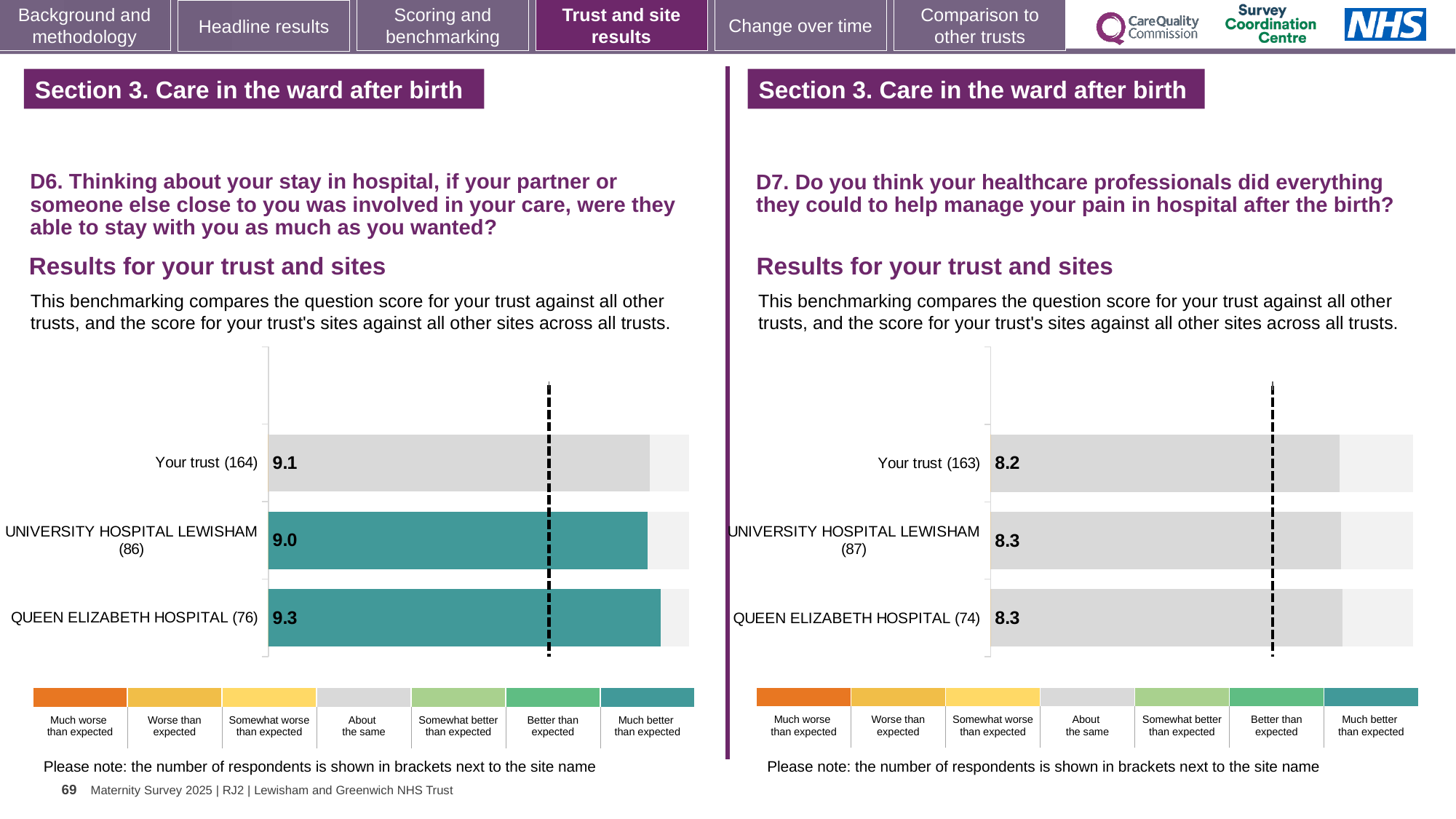
In the D6 chart on the left, which bar has the highest score? QUEEN ELIZABETH HOSPITAL (76) In the D7 chart on the right, how many bars are plotted? 3 In the D6 chart on the left, what is the score for Your trust (164)? 9.1 In the D6 chart on the left, what is the score for QUEEN ELIZABETH HOSPITAL (76)? 9.3 In the D6 chart on the left, what is the score for UNIVERSITY HOSPITAL LEWISHAM (86)? 9.0 In the D6 chart on the left, what colour are the bars for the two hospital sites? Teal In the D6 chart on the left, which bar has the lowest score? UNIVERSITY HOSPITAL LEWISHAM (86) In the D6 chart on the left, what is the difference between the scores for QUEEN ELIZABETH HOSPITAL (76) and UNIVERSITY HOSPITAL LEWISHAM (86)? 0.3 In the D7 chart on the right, what is the score for QUEEN ELIZABETH HOSPITAL (74)? 8.3 In the D7 chart on the right, what is the score for Your trust (163)? 8.2 In the D7 chart on the right, what is the score for UNIVERSITY HOSPITAL LEWISHAM (87)? 8.3 What type of chart is used in the D6 chart on the left? Bar chart